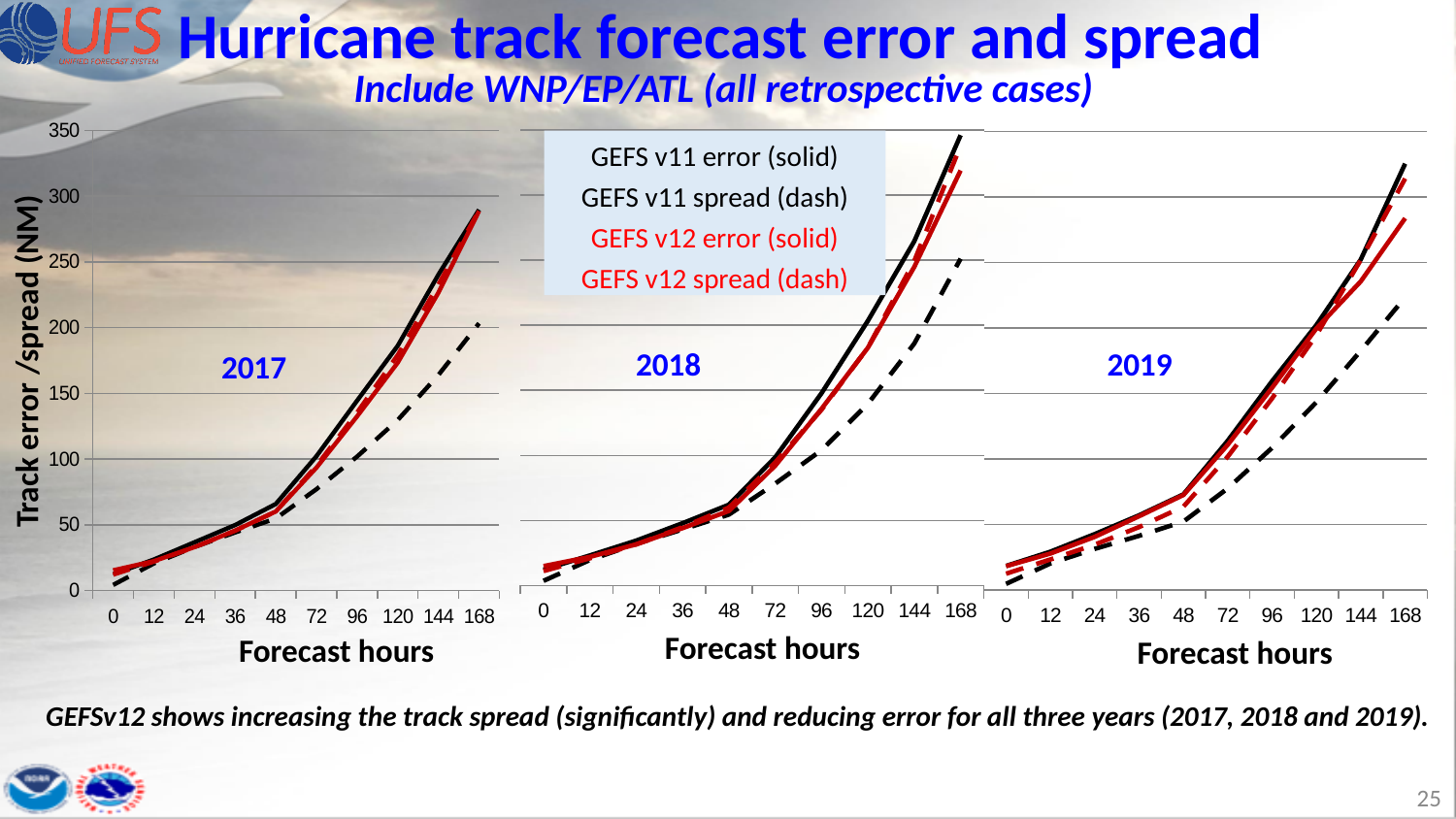
What kind of chart is used for the 2017, 2018 and 2019 panels on this slide? line chart How many forecast-hour tick labels are shown on the x axis of the 2017 chart? 10 In the 2018 chart at 168 forecast hours, which is larger: the GEFS v11 error (solid black) or the GEFS v11 spread (dashed black)? GEFS v11 error In the 2019 chart, is the GEFS v11 spread (dashed black) at 168 forecast hours greater or less than 250? less In the 2018 chart, is the GEFS v11 error (solid black) at 168 forecast hours greater or less than 300? greater Which colour represents the GEFS v12 series in the charts? red How many series does the legend list? 4 What is the label on the y axis of the charts? Track error /spread (NM) In the 2017 chart, is the GEFS v11 error (solid black) at 168 forecast hours greater or less than 250? greater In the 2018 chart, do the track error values rise or fall as forecast hours increase? rise